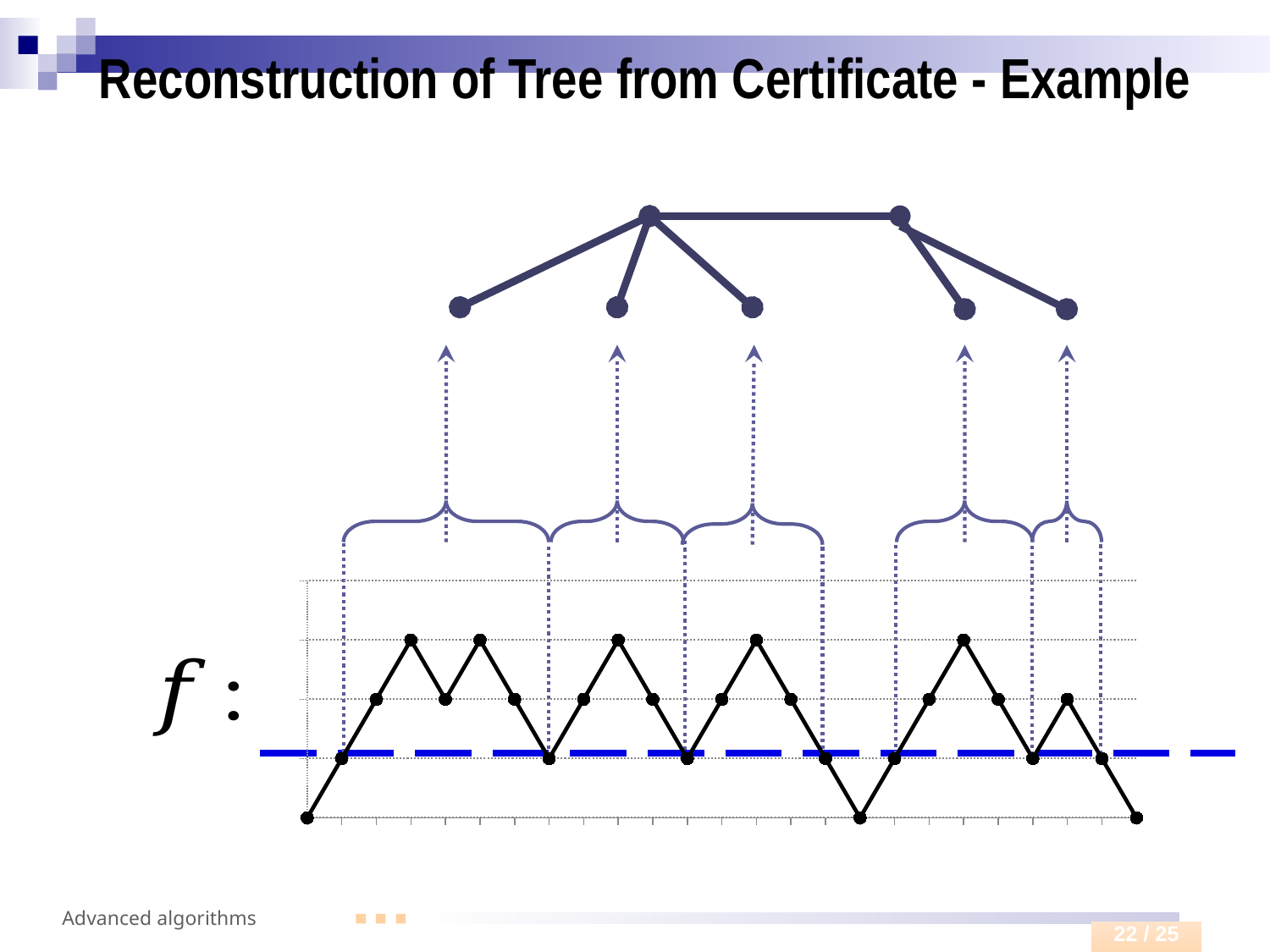
What kind of chart is used to show the function f on the slide? line chart Does the line for f end higher, lower, or at the same level as it starts? same level How many data series are plotted in the chart of f? 1 Does the value of f rise or fall between the second-to-last point and the last point? fall How many data points are plotted on the line for f? 25 How many braces are drawn above the chart of f? 5 How many points of f lie on the lowest level (the x axis)? 3 Does the value of f rise or fall between the first point and the second point? rise What colour is the horizontal dashed line drawn across the chart of f? blue What label is written to the left of the chart? f :